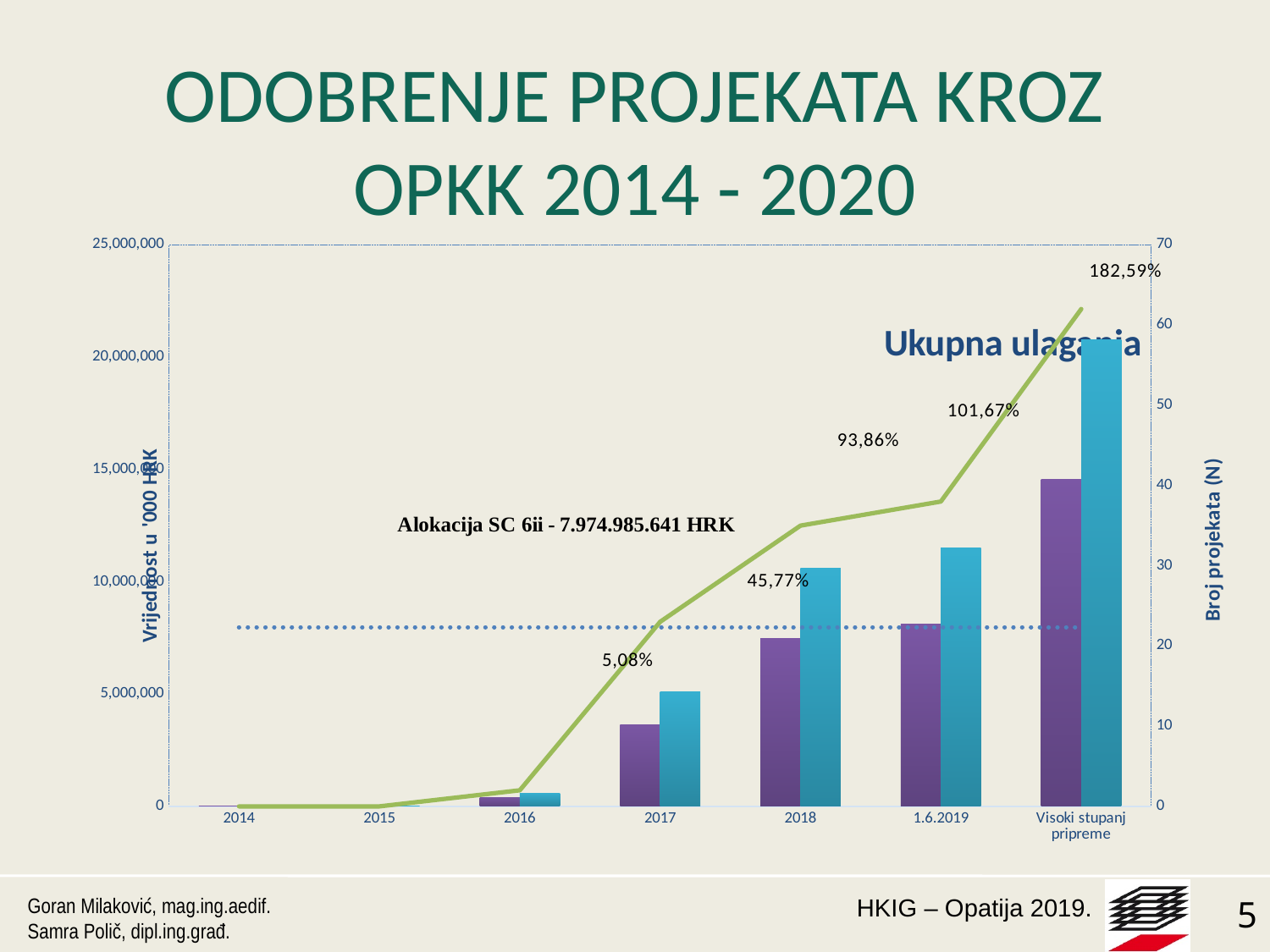
What kind of chart is shown on the slide? bar and line chart What is the title of the left vertical axis of the chart? Vrijednost u '000 HRK What allocation value is stated in the text annotation inside the chart? 7.974.985.641 HRK What is the highest percentage label shown on the line in the chart? 182,59% Which category has the tallest bars in the chart? Visoki stupanj pripreme Is the value of the purple bar for 2017 greater or less than 5,000,000? less Is the value of the teal bar for Visoki stupanj pripreme greater or less than 15,000,000? greater How many categories are shown along the x axis of the chart? 7 Which teal bar is taller, the one for 2018 or the one for 1.6.2019? 1.6.2019 What is the lowest percentage label shown on the line in the chart? 5,08% Do the bar values generally rise or fall from 2014 to Visoki stupanj pripreme? rise On the right axis, is the line value for Visoki stupanj pripreme greater or less than 50? greater